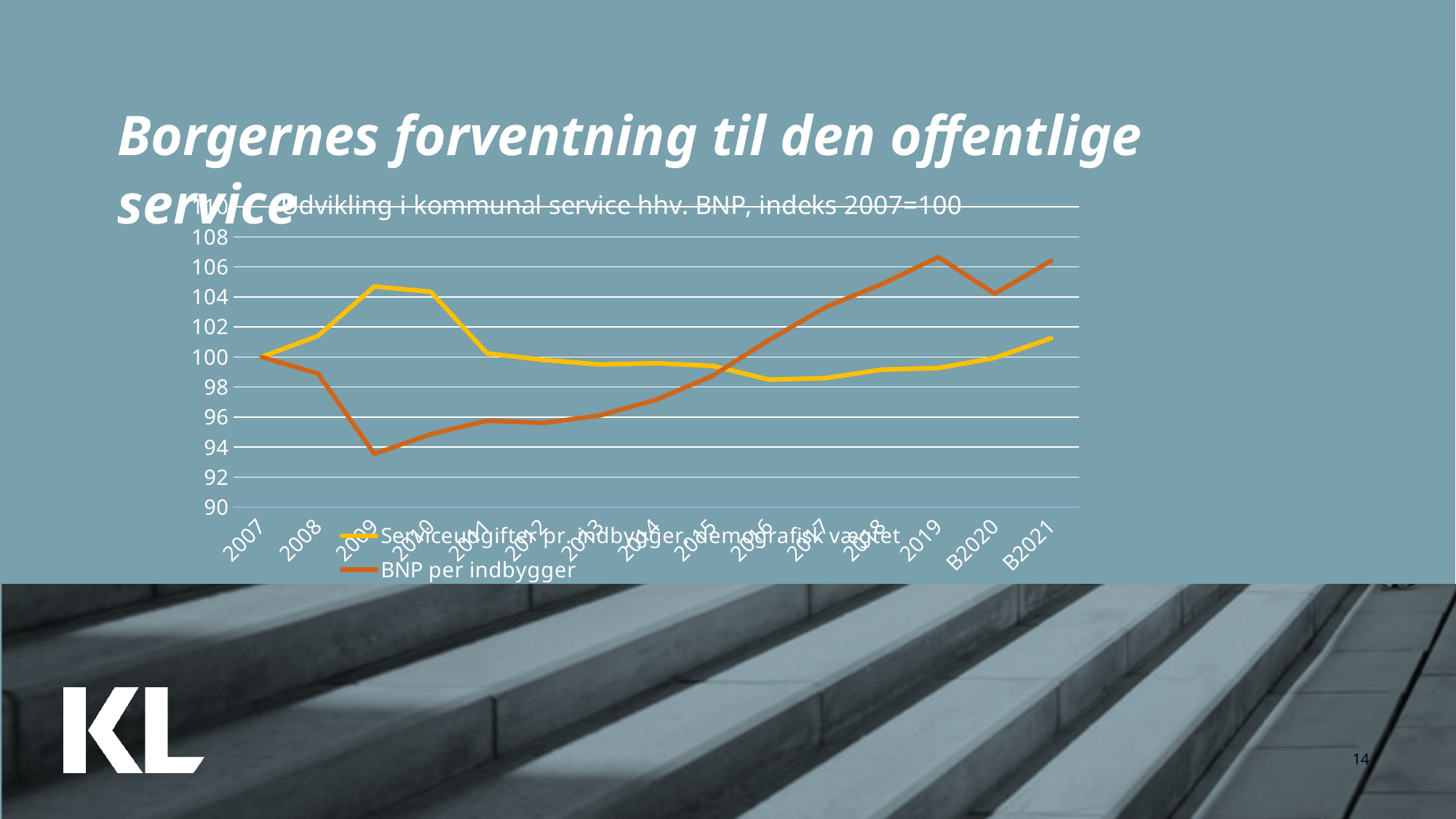
What kind of chart is shown on the slide? line chart Is the value for Serviceudgifter pr. indbygger, demografisk vægtet in 2009 greater or less than 104? greater Which series has the higher value in 2019, Serviceudgifter pr. indbygger, demografisk vægtet or BNP per indbygger? BNP per indbygger What is the value of Serviceudgifter pr. indbygger, demografisk vægtet in 2007? 100 How many series does the chart legend list? 2 What is the value of BNP per indbygger in 2007? 100 Is the value for Serviceudgifter pr. indbygger, demografisk vægtet in 2016 greater or less than 100? less How many points are plotted along the x axis of the chart? 15 In which year is BNP per indbygger at its lowest? 2009 What is the title of the chart? Udvikling i kommunal service hhv. BNP, indeks 2007=100 Is the value for BNP per indbygger in 2009 greater or less than 94? less Does BNP per indbygger rise or fall between 2009 and 2019? rise